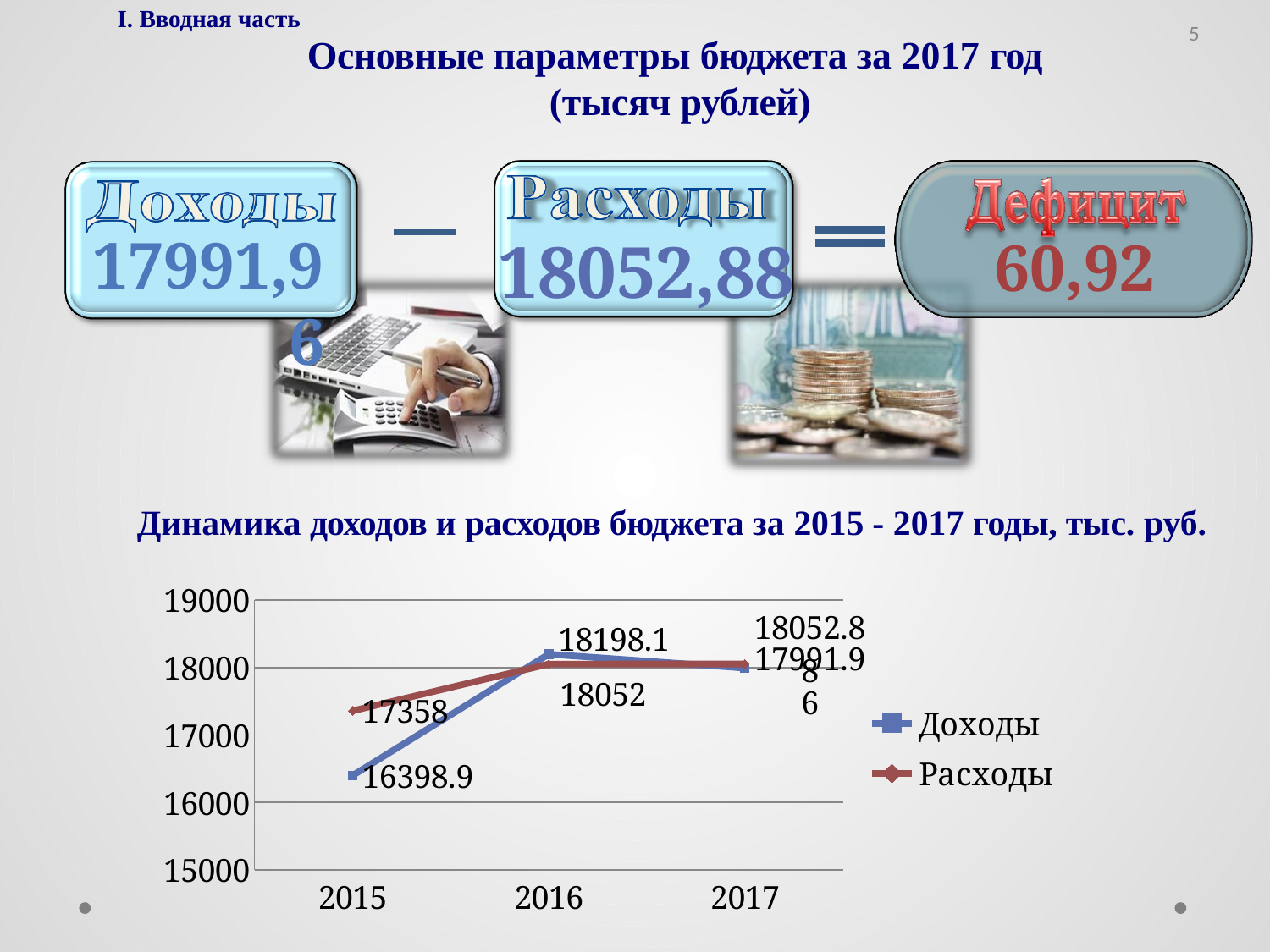
In which year is Доходы highest? 2016 In which year is Доходы lowest? 2015 What is the value of Расходы in 2015? 17358 What kind of chart is shown on the slide? line chart What is the difference between Доходы and Расходы in 2016? 146.1 How many years are plotted on the x axis of the chart? 3 What is the value of Расходы in 2016? 18052 What is the value of Доходы in 2015? 16398.9 How many series does the chart legend list? 2 Does Расходы rise or fall from 2015 to 2016? rise In 2015, which is larger, Доходы or Расходы? Расходы What is the value of Доходы in 2016? 18198.1